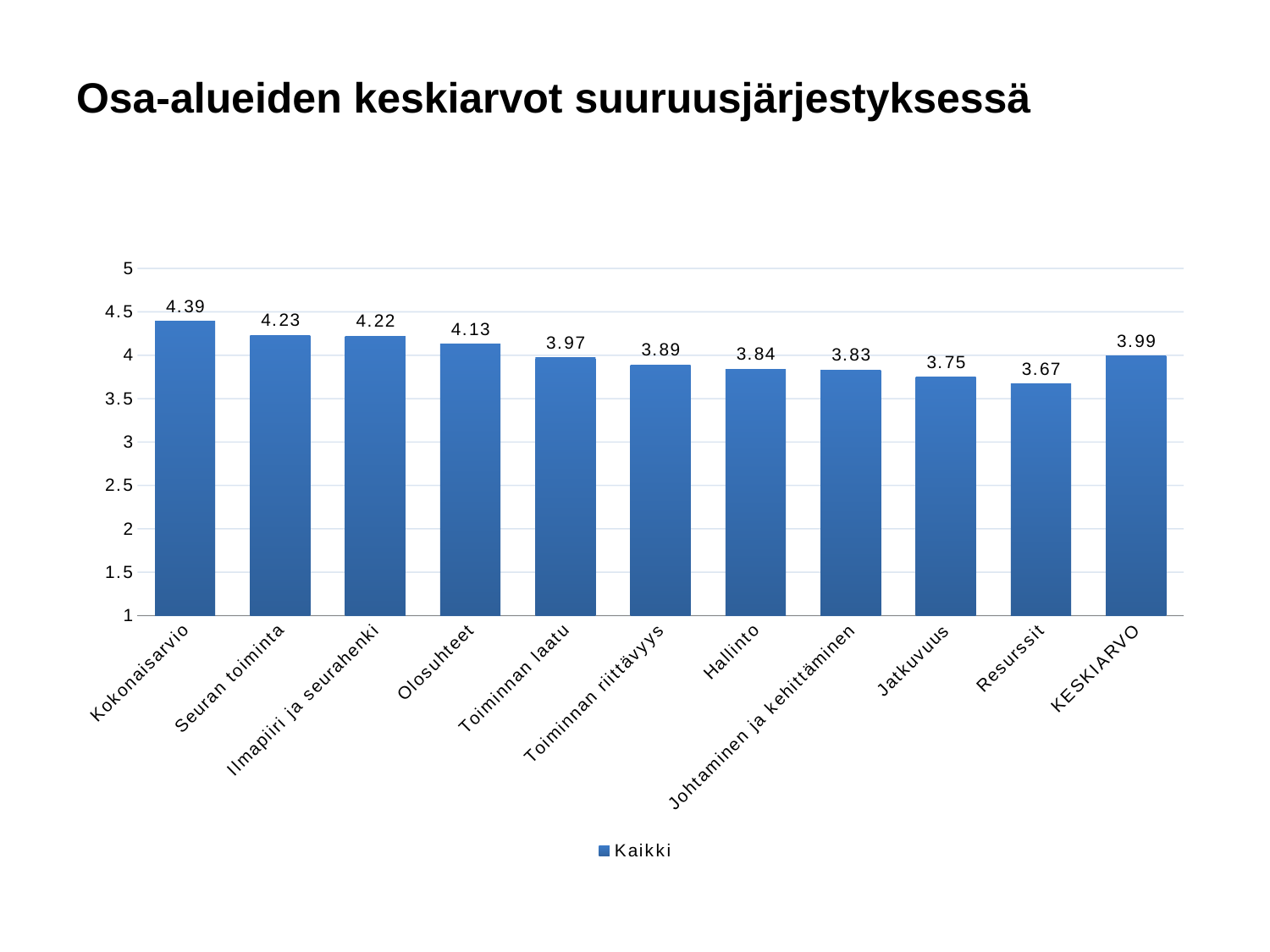
What is the name of the series in the legend? Kaikki Which is larger, the value for Olosuhteet or the value for Jatkuvuus? Olosuhteet How many series does the legend list? 1 What is the value for Hallinto? 3.84 Is the value for Toiminnan laatu greater or less than 3.5? greater What is the value for KESKIARVO? 3.99 What kind of chart is shown on the slide? bar chart Which category has the lowest value? Resurssit Which category has the highest value? Kokonaisarvio How many categories are shown on the x axis? 11 What is the difference between the values for Kokonaisarvio and Resurssit? 0.72 What is the value for Kokonaisarvio? 4.39